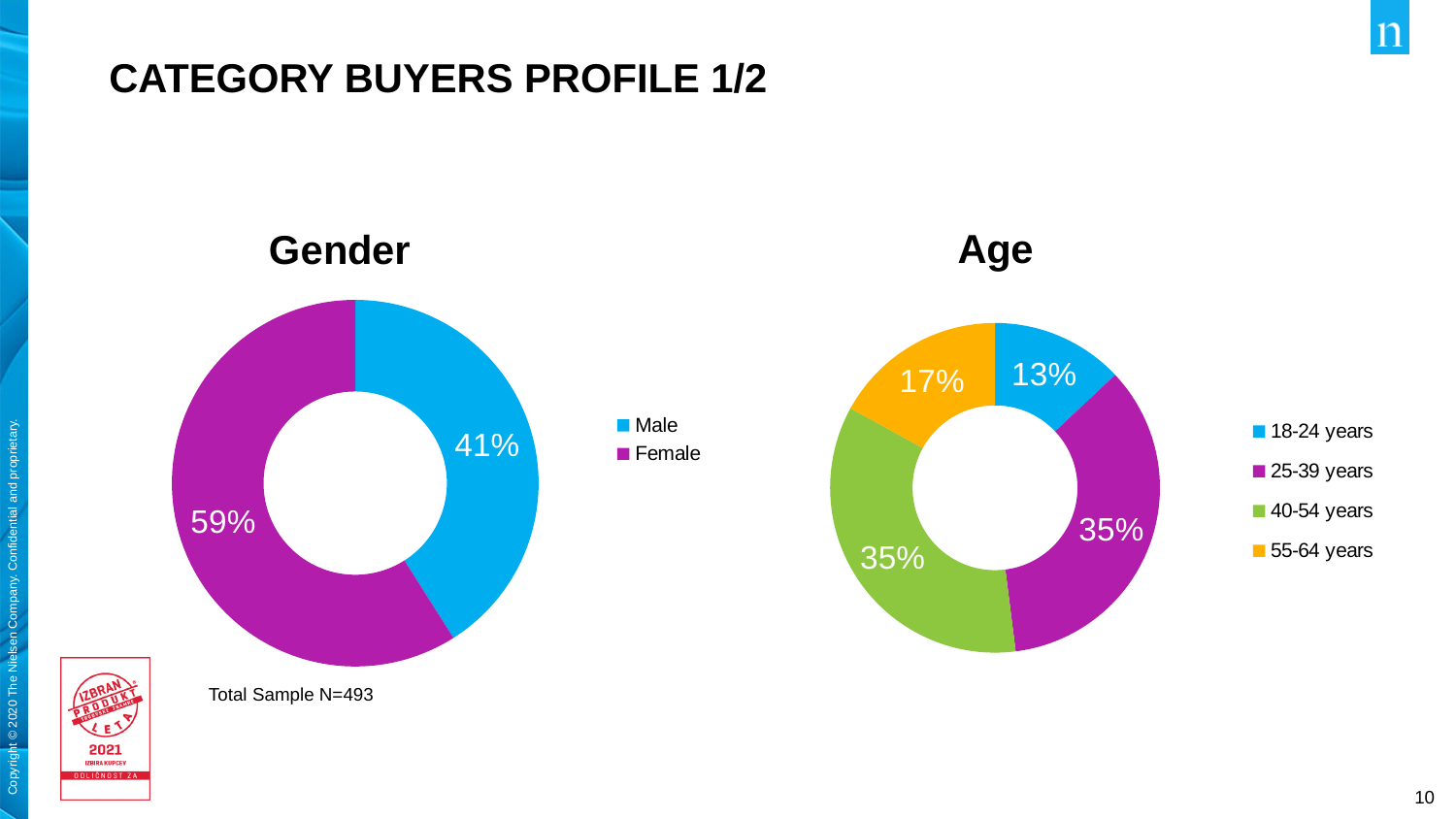
What type of chart is the Gender chart? Doughnut chart In the Age chart, what percentage of buyers are 18-24 years? 13% In the Age chart, what is the combined share of the 25-39 years and 40-54 years groups? 70% In the Age chart, is the share for 55-64 years larger or smaller than the share for 18-24 years? larger In the Gender chart, which gender has the larger share? Female In the Age chart, which age group has the smallest share? 18-24 years In the Age chart, what percentage of buyers are 55-64 years? 17% In the Age chart, which colour represents the 40-54 years group? Green In the Age chart, how many age groups are shown? 4 In the Gender chart, what percentage of category buyers are Female? 59% In the Gender chart, what is the difference in percentage points between Female and Male? 18 In the Gender chart, what percentage of category buyers are Male? 41%